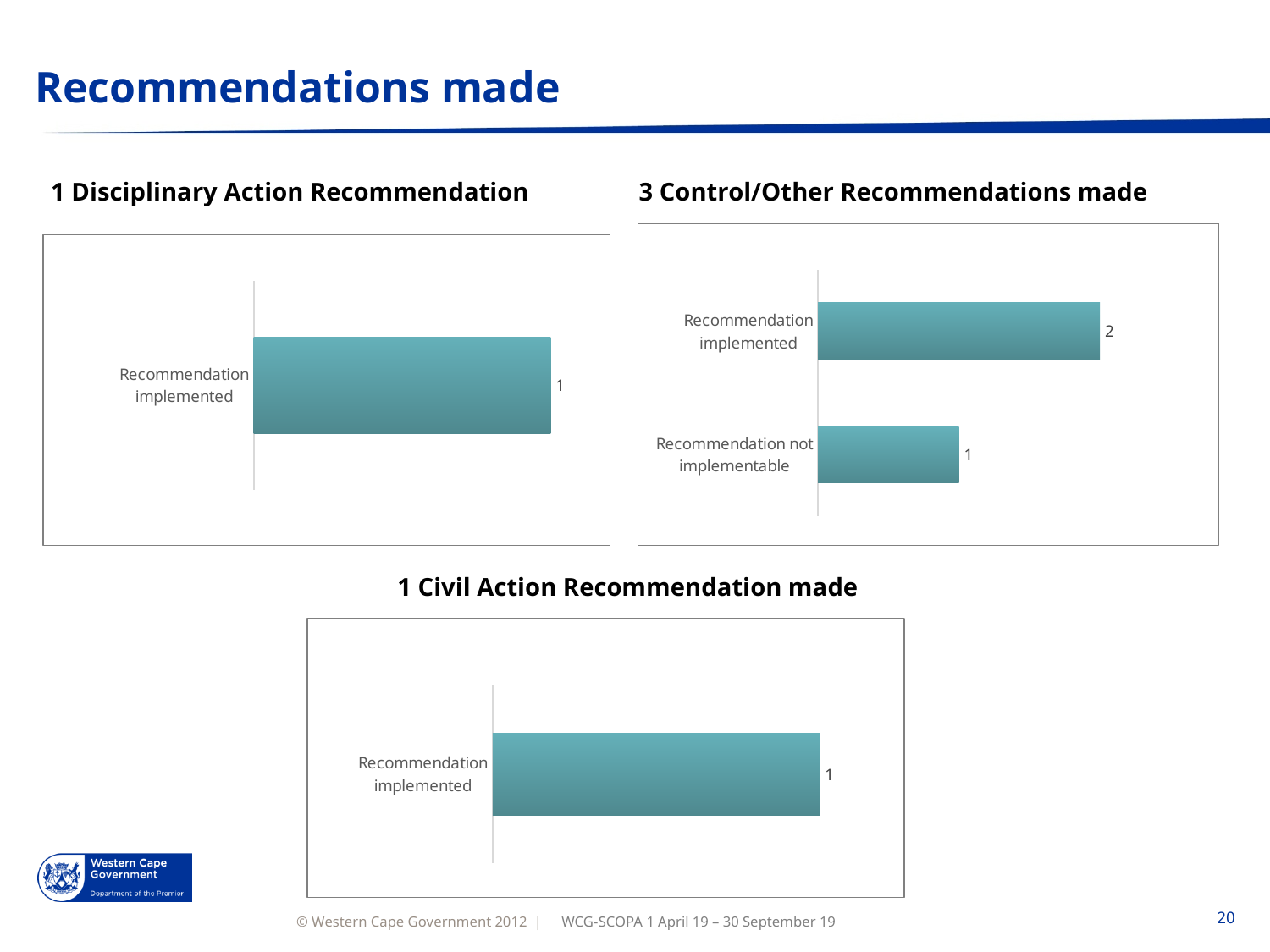
In the '3 Control/Other Recommendations made' chart, which category has the lowest value? Recommendation not implementable In the '1 Civil Action Recommendation made' chart, what is the value for 'Recommendation implemented'? 1 In the '3 Control/Other Recommendations made' chart, what is the value for 'Recommendation implemented'? 2 How many charts are shown on the slide? 3 What type of chart is the '1 Civil Action Recommendation made' chart? Bar chart In the '3 Control/Other Recommendations made' chart, which is larger: 'Recommendation implemented' or 'Recommendation not implementable'? Recommendation implemented In the '3 Control/Other Recommendations made' chart, what is the value for 'Recommendation not implementable'? 1 In the '1 Disciplinary Action Recommendation' chart, what is the value for 'Recommendation implemented'? 1 How many categories are shown in the '1 Disciplinary Action Recommendation' chart? 1 In the '3 Control/Other Recommendations made' chart, what is the difference between 'Recommendation implemented' and 'Recommendation not implementable'? 1 In the '3 Control/Other Recommendations made' chart, which category has the highest value? Recommendation implemented How many categories are shown in the '3 Control/Other Recommendations made' chart? 2